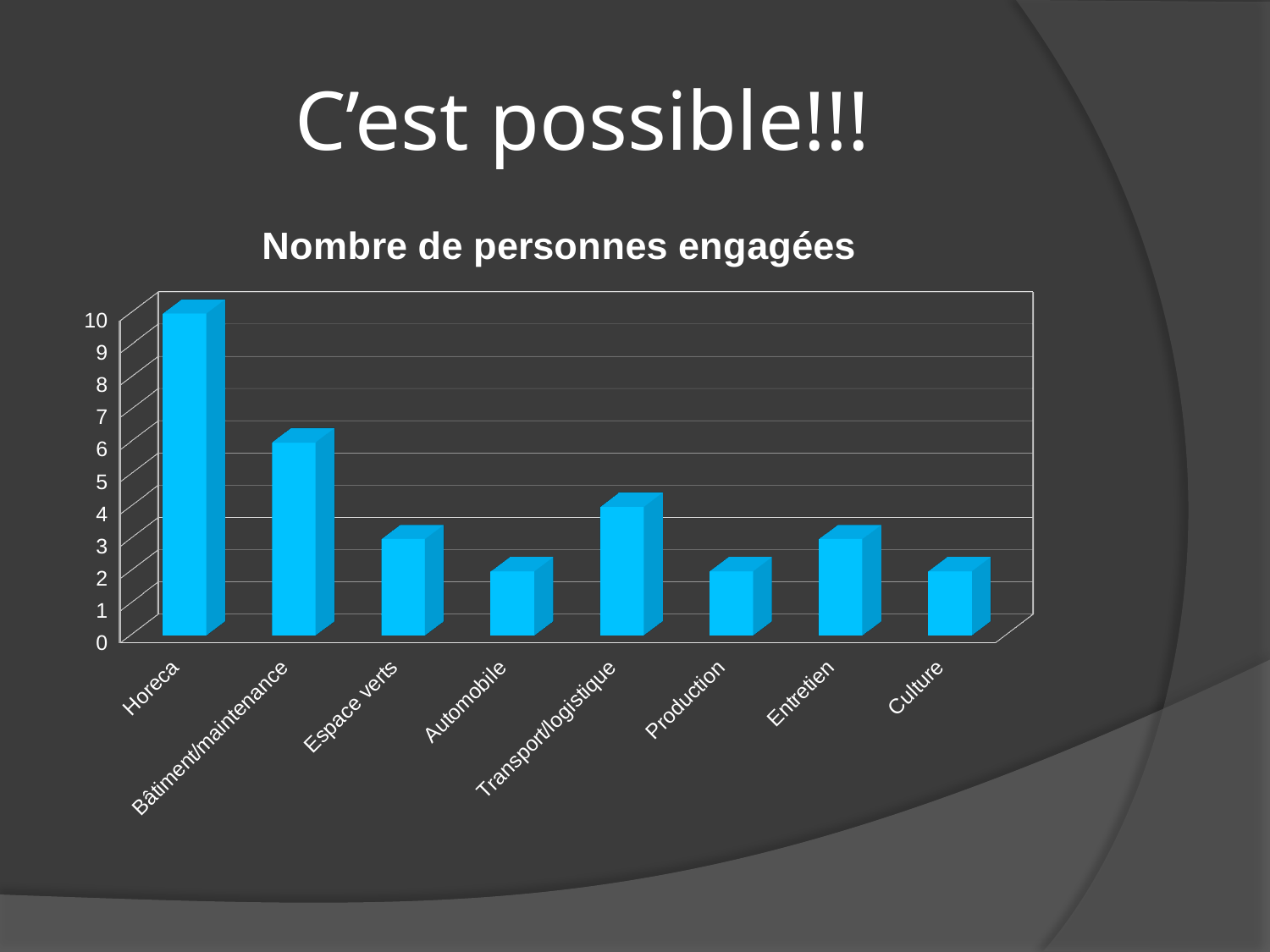
What is the title of the chart? Nombre de personnes engagées How many categories are shown on the x axis of the chart? 8 Is the value for Automobile greater or less than 5? less Which is larger, the value for Espace verts or the value for Horeca? Horeca What is the difference between the values for Horeca and Bâtiment/maintenance? 4 What is the value for Transport/logistique? 4 Is the value for Horeca greater or less than 8? greater What is the value for Horeca? 10 Which category has the highest number of people engaged? Horeca What is the value for Bâtiment/maintenance? 6 What kind of chart is shown on the slide? bar chart Which is larger, the value for Bâtiment/maintenance or the value for Transport/logistique? Bâtiment/maintenance